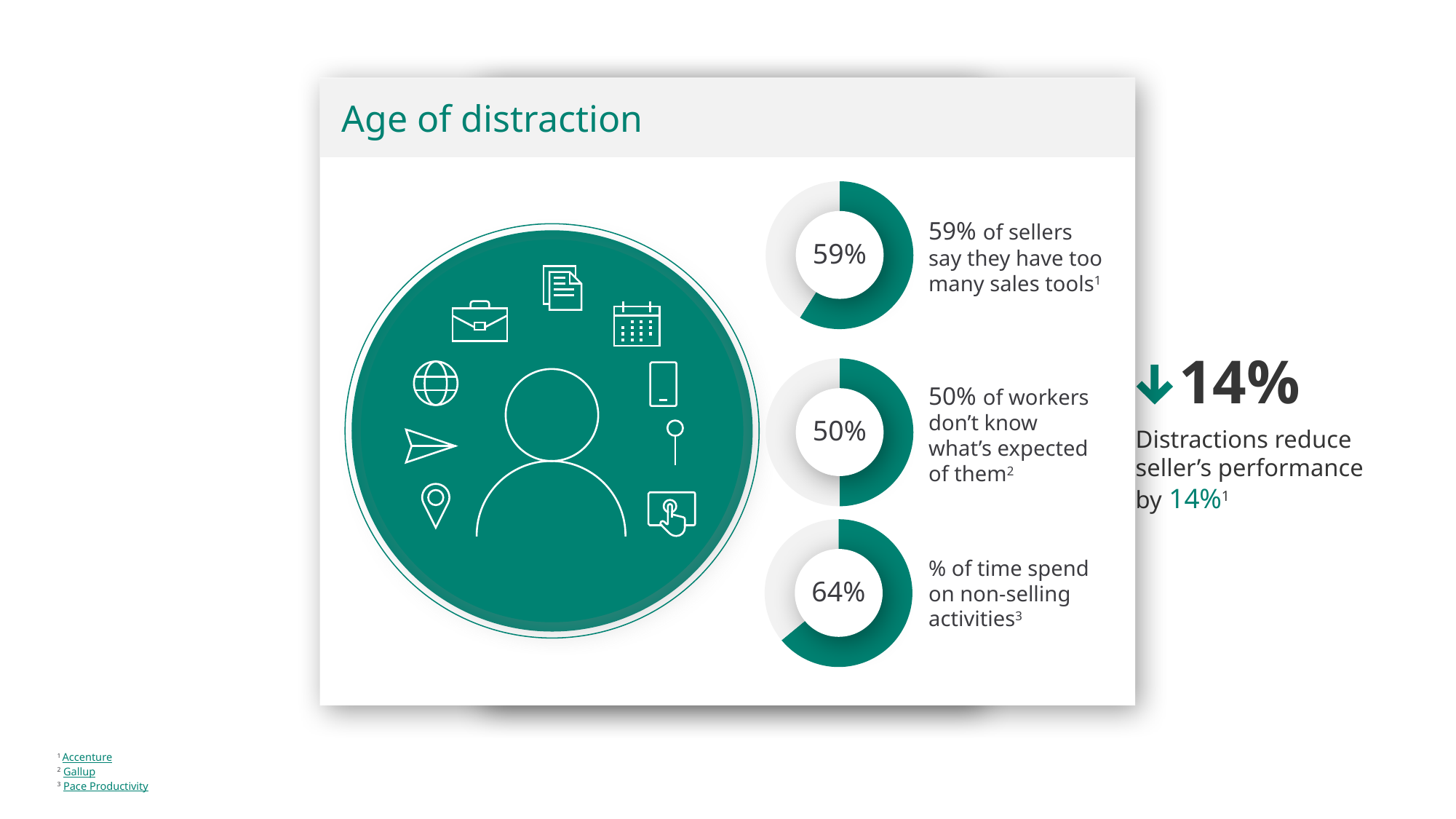
On the middle donut chart, what share of the ring is filled in dark green? 50% Which of the three donut charts shows the highest percentage? % of time spend on non-selling activities (64%) Which is larger: the percentage on the top donut chart (sellers with too many sales tools) or the percentage on the bottom donut chart (time on non-selling activities)? Time on non-selling activities (64%) What is the difference between the percentage on the top donut chart (too many sales tools) and the percentage on the middle donut chart (workers who don't know what's expected)? 9% How many donut charts are shown on the slide? 3 On the bottom donut chart, what percentage of time is spent on non-selling activities? 64% On the top donut chart, what percentage of sellers say they have too many sales tools? 59% What is the title of the slide containing the donut charts? Age of distraction Which of the three donut charts shows the lowest percentage? 50% of workers don't know what's expected of them What is the difference between the percentage on the bottom donut chart (non-selling activities) and the percentage on the middle donut chart (workers who don't know what's expected)? 14% On the middle donut chart, what percentage of workers don't know what's expected of them? 50% What kind of charts are used to show the three percentages on the slide? Donut charts